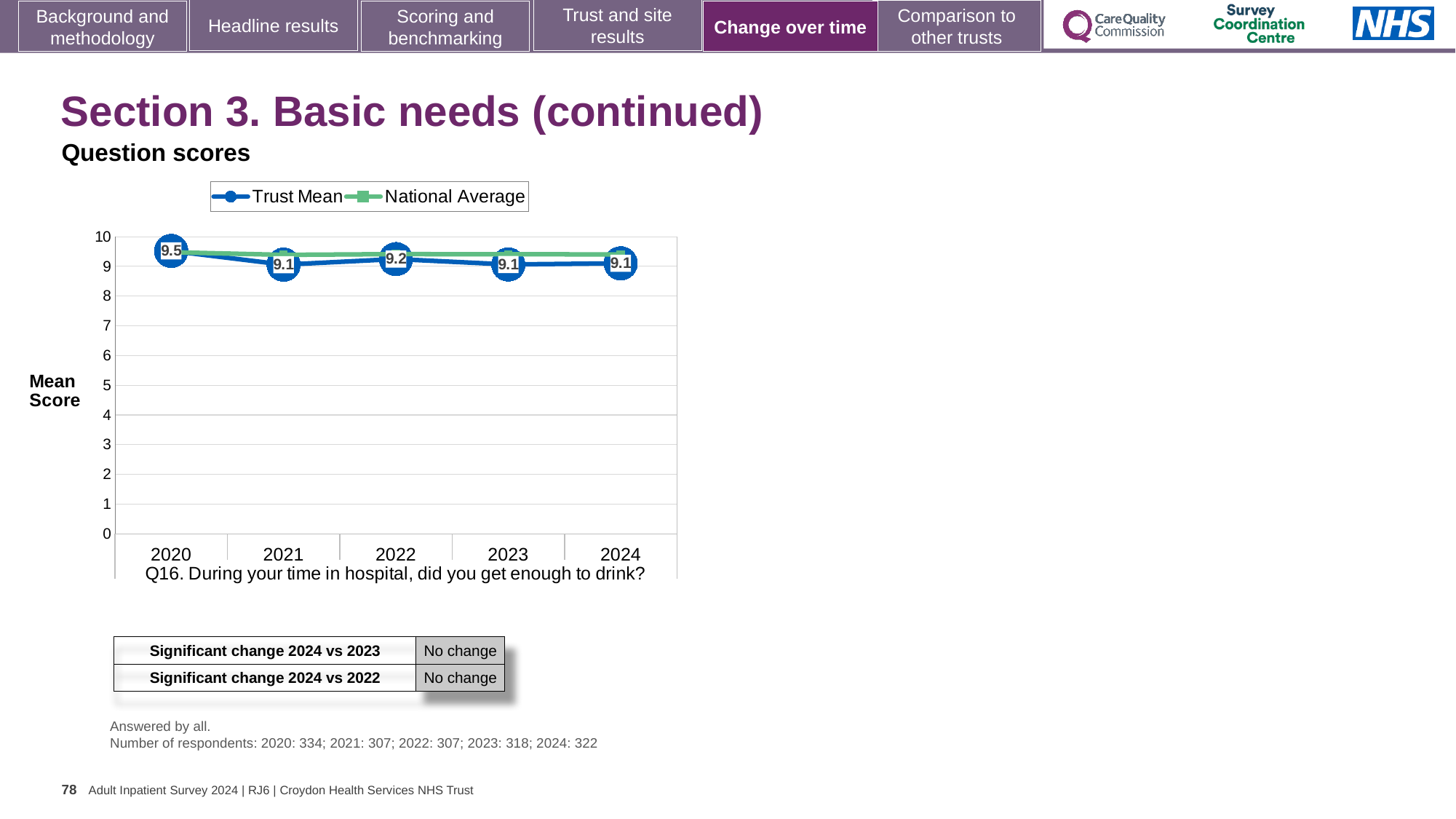
Which year has the larger Trust Mean score, 2020 or 2022? 2020 What is the difference between the Trust Mean score in 2020 and in 2021? 0.4 What is the Trust Mean score for 2024? 9.1 Is the National Average value for 2024 greater or less than 8? greater How many years are plotted on the x axis? 5 Does the Trust Mean score rise or fall from 2020 to 2024? Fall How many series does the legend list? 2 What kind of chart is shown on the slide? Line chart What is the Trust Mean score for 2022? 9.2 What is the Trust Mean score for 2020? 9.5 In which year is the Trust Mean score highest? 2020 What is the label on the y axis of the chart? Mean Score